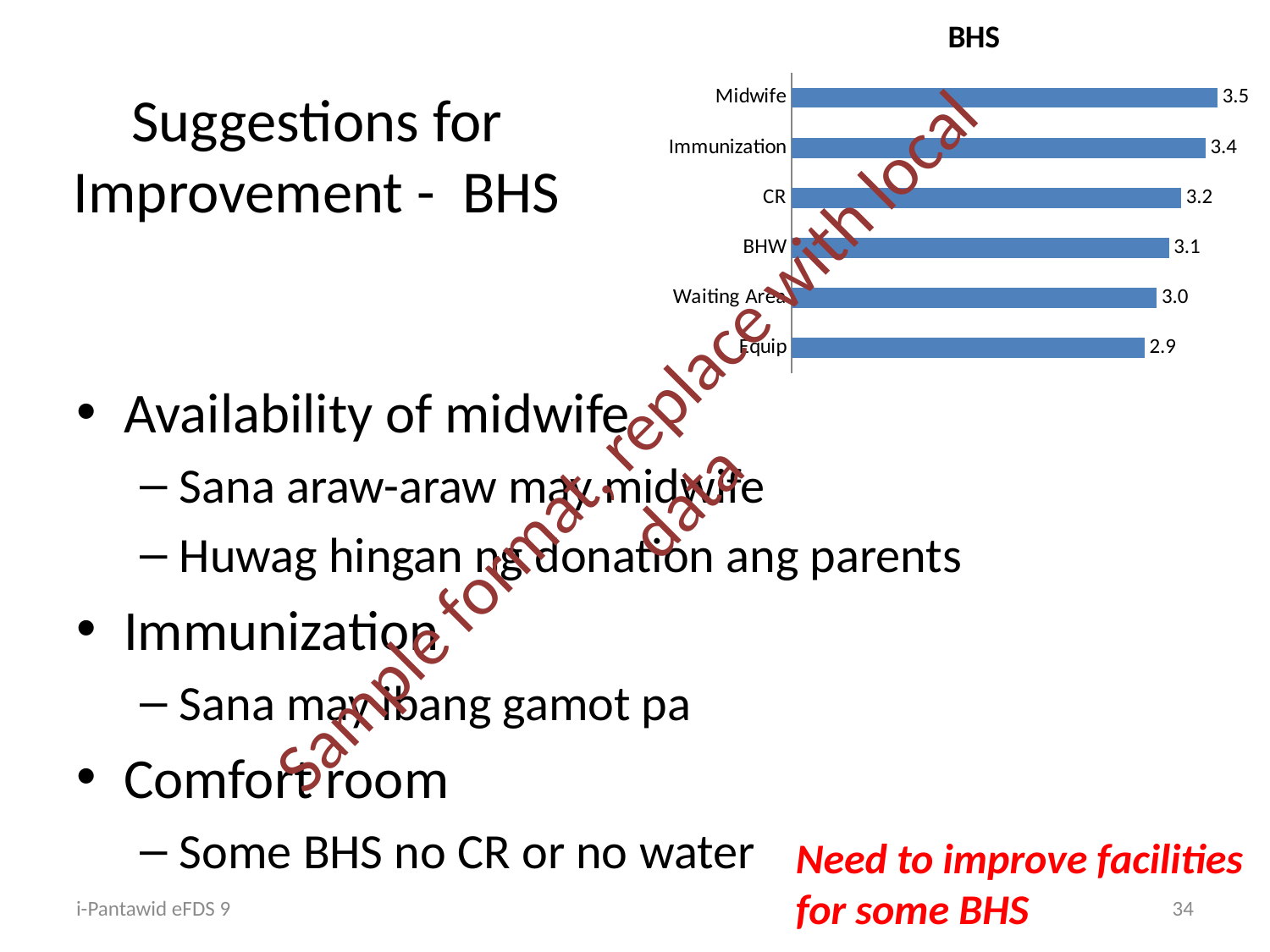
How many categories are shown in the BHS chart? 6 What type of chart is the BHS chart? Bar chart What is the title of the chart on the slide? BHS What is the value for Midwife in the BHS chart? 3.5 Which category has the lowest value in the BHS chart? Equip Which category has the highest value in the BHS chart? Midwife What is the value for Immunization in the BHS chart? 3.4 Which has a larger value in the BHS chart, CR or Waiting Area? CR What is the value for Equip in the BHS chart? 2.9 What is the value for CR in the BHS chart? 3.2 What is the difference between the values for Midwife and Equip in the BHS chart? 0.6 What is the difference between the values for BHW and Waiting Area in the BHS chart? 0.1